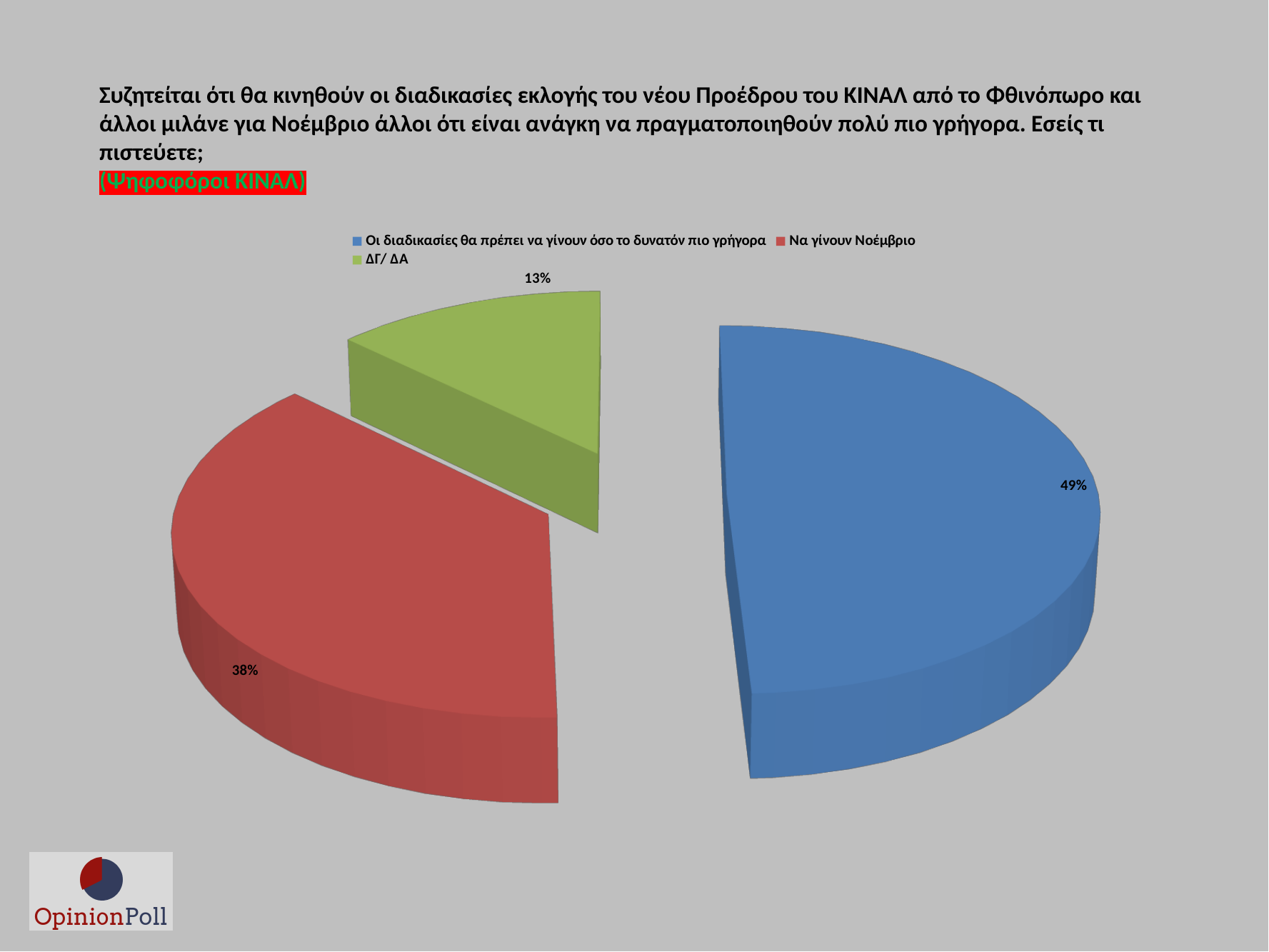
What percentage of respondents answered "ΔΓ/ ΔΑ"? 13% Which response has the smallest share of the pie? ΔΓ/ ΔΑ How many entries does the legend list? 3 Which is larger: the share for "Να γίνουν Νοέμβριο" or the share for "ΔΓ/ ΔΑ"? Να γίνουν Νοέμβριο How many slices does the pie chart have? 3 What colour is the slice for "Να γίνουν Νοέμβριο"? red What is the difference in percentage points between "Να γίνουν Νοέμβριο" and "ΔΓ/ ΔΑ"? 25 percentage points What percentage of respondents chose "Οι διαδικασίες θα πρέπει να γίνουν όσο το δυνατόν πιο γρήγορα"? 49% What kind of chart is shown on the slide? pie chart What percentage of respondents chose "Να γίνουν Νοέμβριο"? 38% Which response has the largest share of the pie? Οι διαδικασίες θα πρέπει να γίνουν όσο το δυνατόν πιο γρήγορα What is the difference in percentage points between "Οι διαδικασίες θα πρέπει να γίνουν όσο το δυνατόν πιο γρήγορα" and "Να γίνουν Νοέμβριο"? 11 percentage points